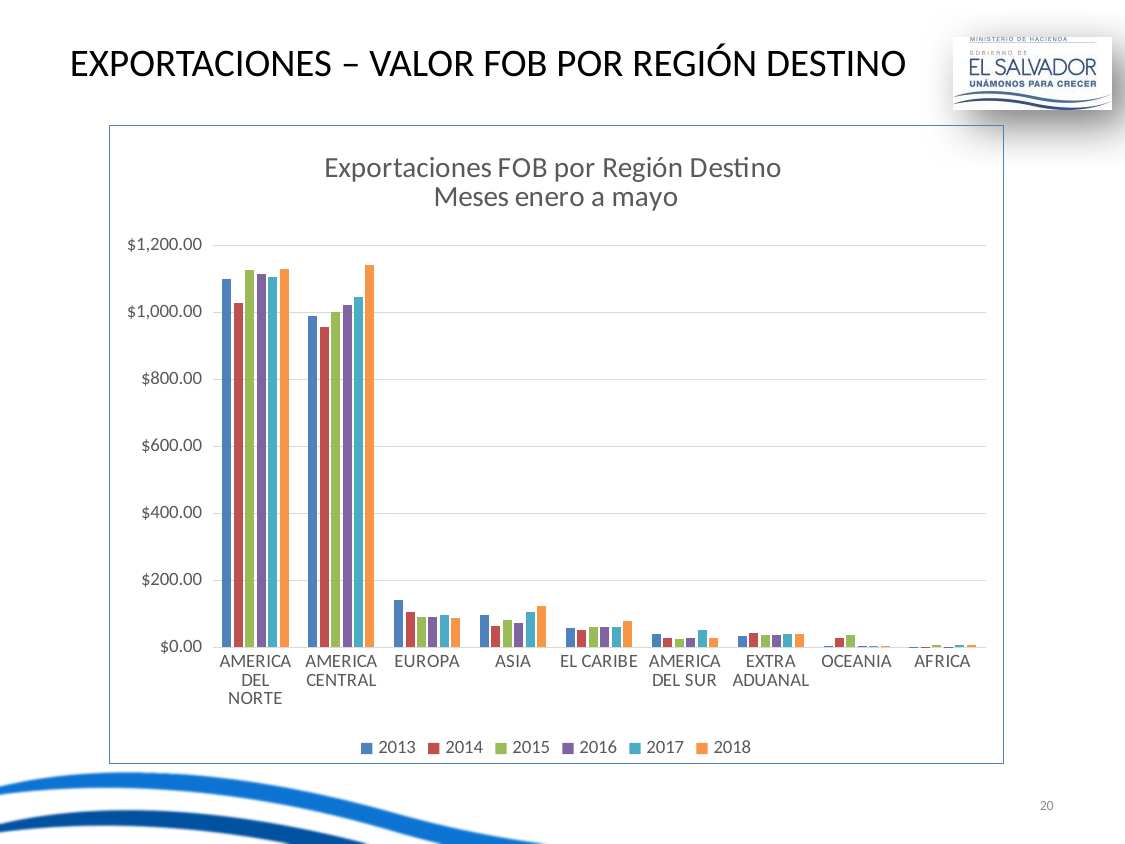
Is the 2018 value for AMERICA CENTRAL greater or less than $1,000.00? greater Which region has the highest value for 2013? AMERICA DEL NORTE Which region has the lowest values across all years? AFRICA Is the 2013 value for EUROPA greater or less than $200.00? less How many destination regions are shown on the x axis of the chart? 9 For 2013, which is larger: the value for EUROPA or the value for ASIA? EUROPA Is the 2014 value for AMERICA CENTRAL greater or less than $1,000.00? less What is the title of the chart? Exportaciones FOB por Región Destino Meses enero a mayo What kind of chart is shown on the slide? Bar chart How many series (years) does the chart legend list? 6 Do the values for AMERICA CENTRAL rise or fall from 2014 to 2018? rise